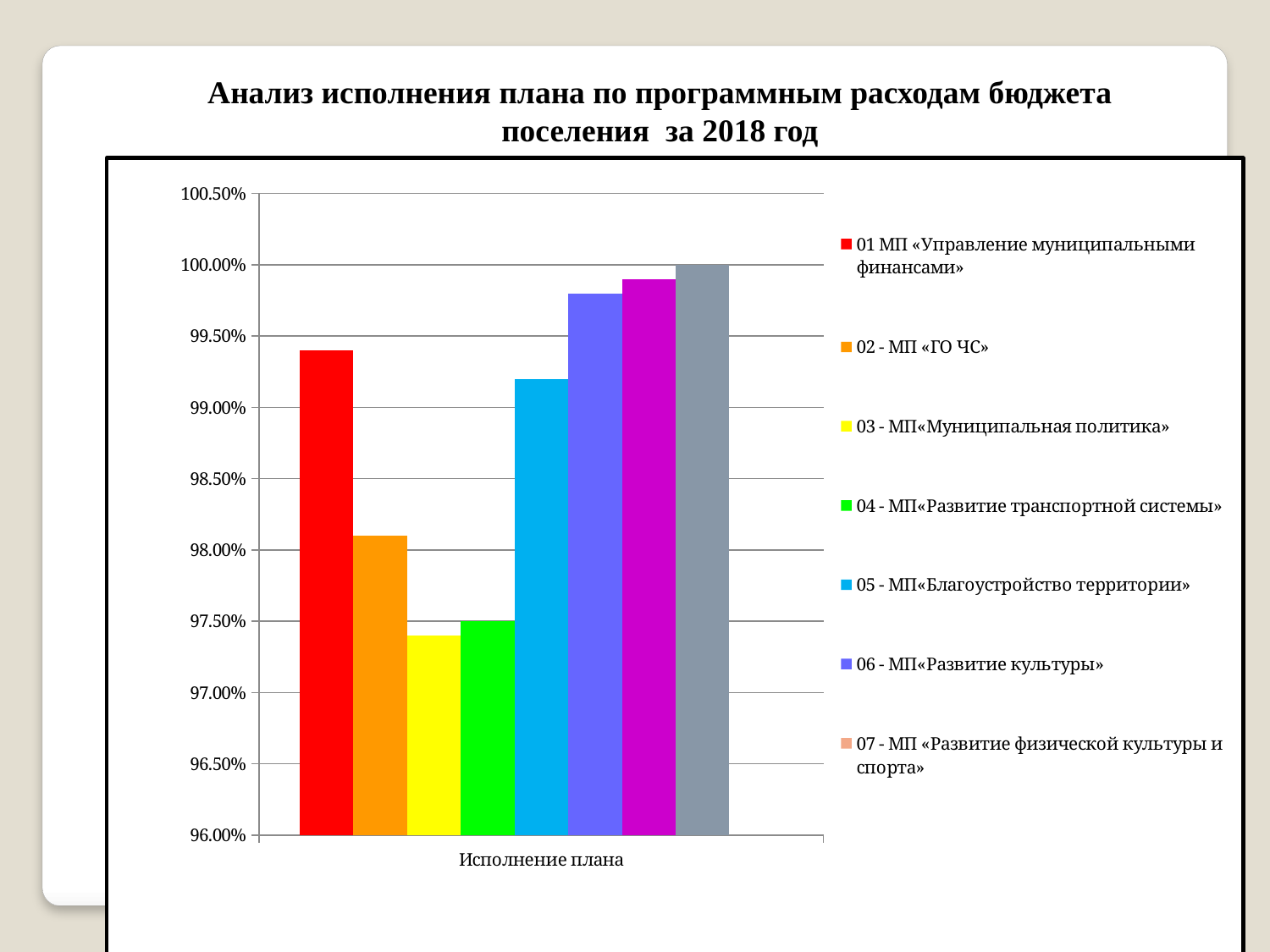
Is the value for 01 МП «Управление муниципальными финансами» greater or less than 99.00%? greater Is the value for 06 - МП«Развитие культуры» greater or less than 99.50%? greater What is the label shown under the x axis of the chart? Исполнение плана Which is larger, the value for 01 МП «Управление муниципальными финансами» or for 02 - МП «ГО ЧС»? 01 МП «Управление муниципальными финансами» Is the value for 02 - МП «ГО ЧС» greater or less than 98.50%? less How many bars are plotted in the chart? 8 How many series does the legend list? 7 What kind of chart is shown on the slide? bar chart Which legend series has the lowest bar? 03 - МП«Муниципальная политика» Which is larger, the value for 05 - МП«Благоустройство территории» or for 06 - МП«Развитие культуры»? 06 - МП«Развитие культуры»